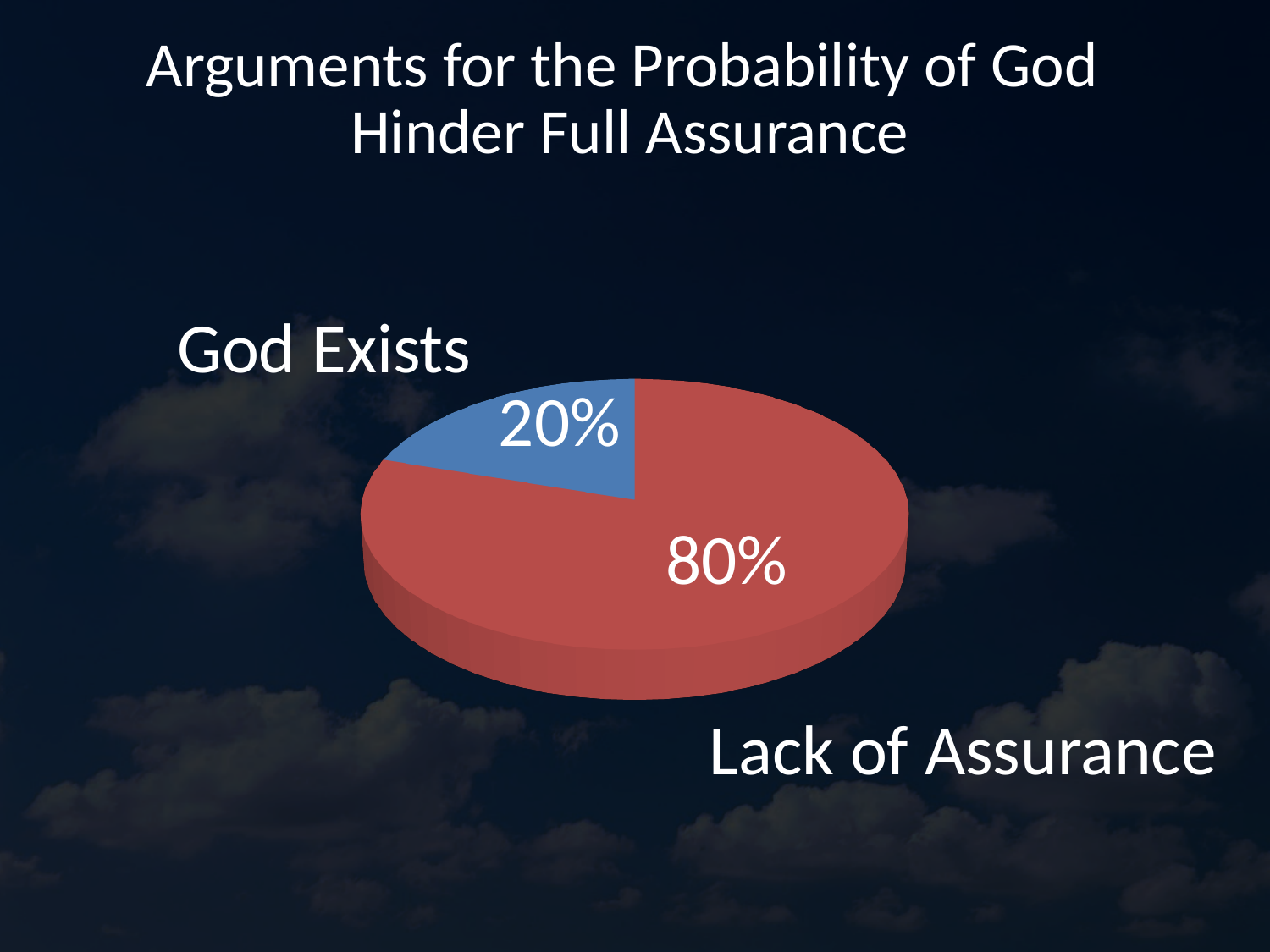
Which slice is the largest? Lack of Assurance What percentage is shown for the Lack of Assurance slice? 80% What colour is the Lack of Assurance slice? Red How many slices does the pie chart have? 2 What percentage is shown for the God Exists slice? 20% What kind of chart is shown on the slide? Pie chart What is the difference between the Lack of Assurance and God Exists slices? 60% Which slice is the smallest? God Exists What is the title of the slide containing the chart? Arguments for the Probability of God Hinder Full Assurance What share of the pie does the God Exists slice represent? 20% Which is larger, the God Exists slice or the Lack of Assurance slice? Lack of Assurance